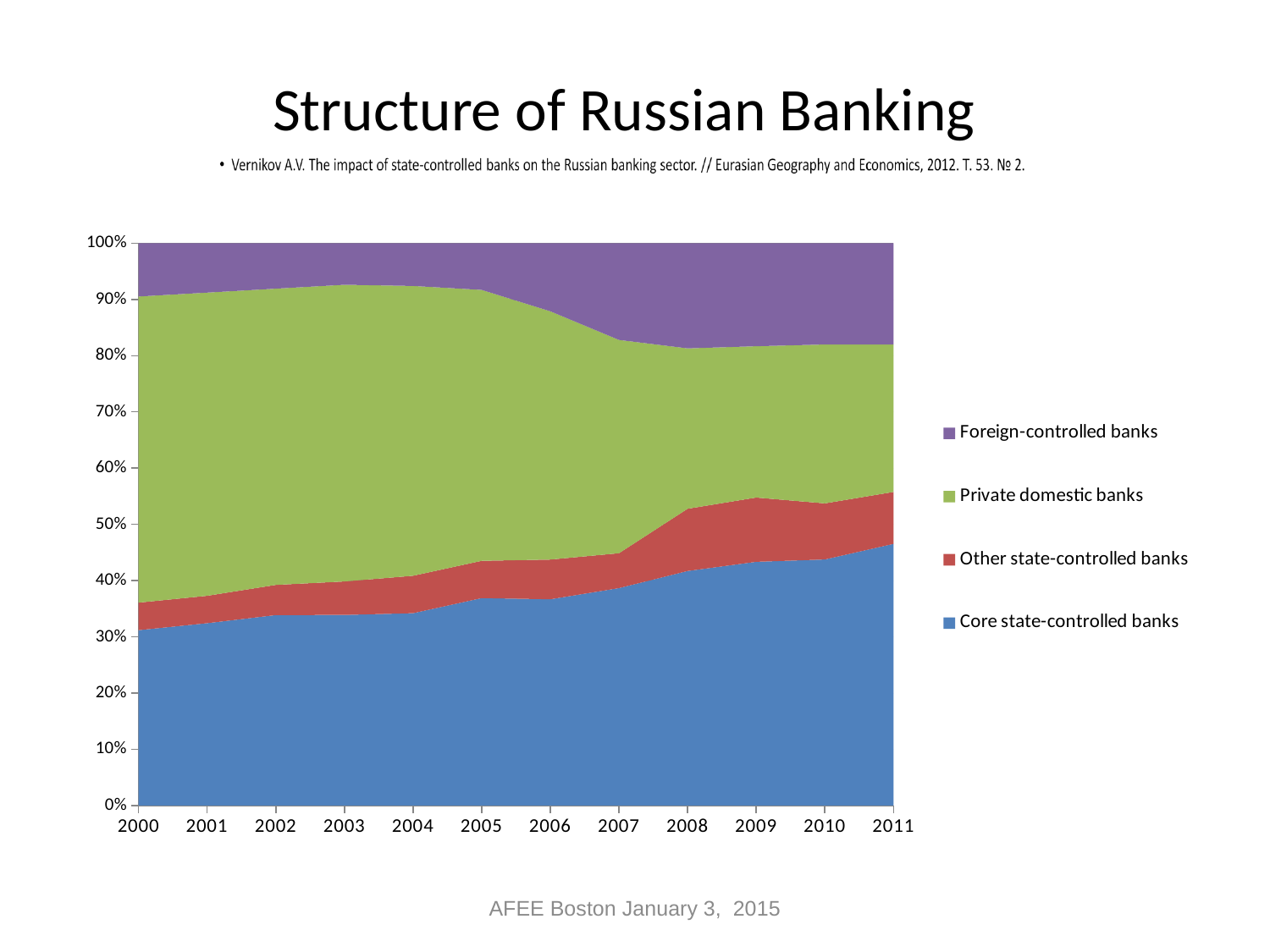
How many years are shown along the x axis? 12 Does the share of Core state-controlled banks rise or fall from 2000 to 2011? rise Which series has the largest share in 2000? Private domestic banks Is the share of Core state-controlled banks larger in 2000 or in 2011? 2011 Which series is shown in purple in the legend? Foreign-controlled banks Is the share of Core state-controlled banks in 2000 greater or less than 40%? less How many series does the legend list? 4 Is the share of Core state-controlled banks in 2011 greater or less than 40%? greater Does the share of Private domestic banks rise or fall from 2000 to 2011? fall Which series has the smallest share in 2000? Other state-controlled banks What is the first year shown on the x axis? 2000 What kind of chart is shown on the slide? Stacked area chart